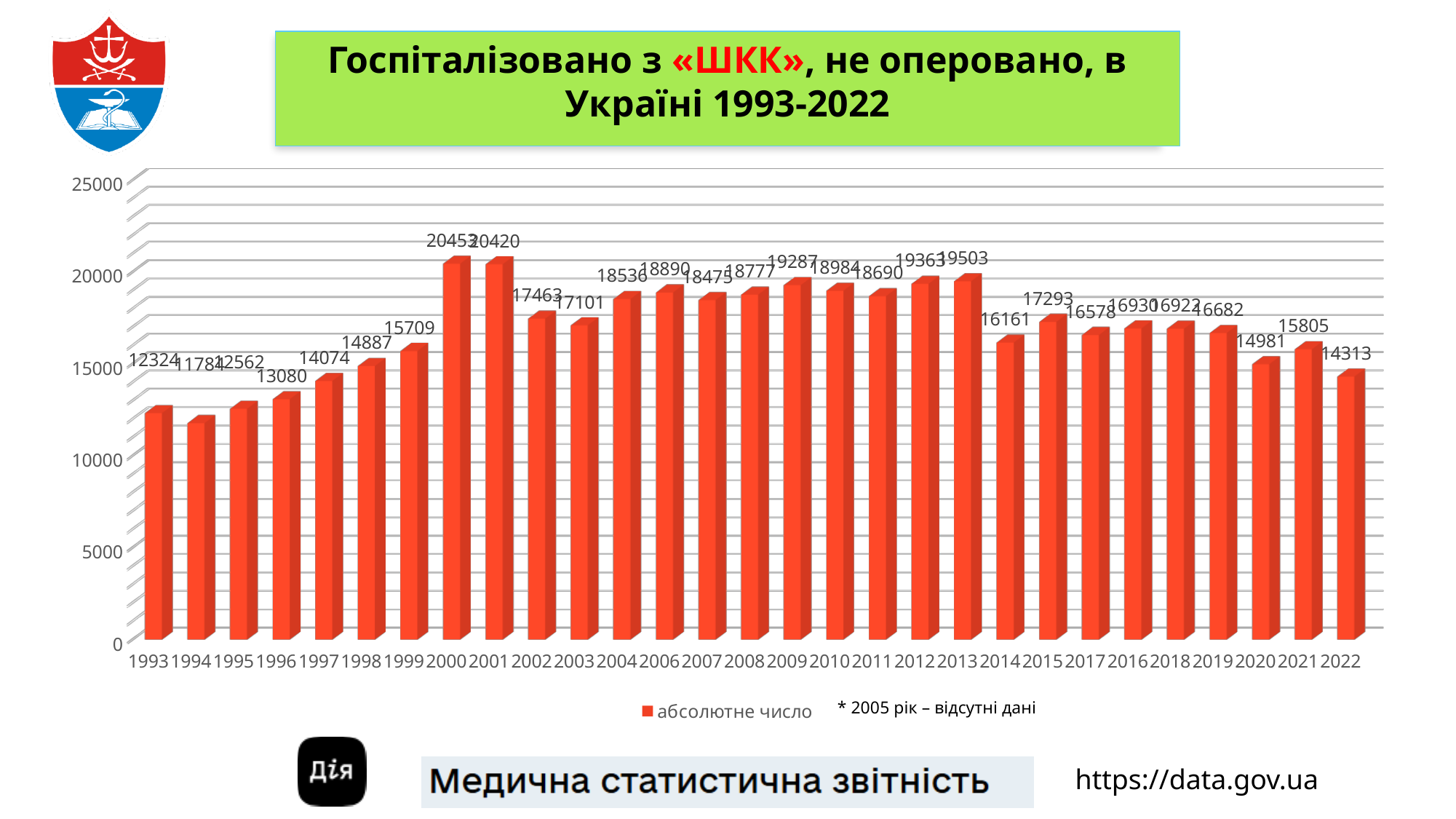
Is the value for 2001 greater or less than 20000? greater Do the values rise or fall from 1994 to 1999? rise What is the value for 2022? 14313 Which is larger, the value for 2014 or the value for 2015? 2015 How many series does the legend list? 1 What is the value for 1993? 12324 What kind of chart is shown on the slide? bar chart How many bars are shown in the chart? 29 What is the difference between the values for 2021 and 2020? 824 What is the value for 2013? 19503 What is the value for 2009? 19287 Which year has the lowest value? 1994